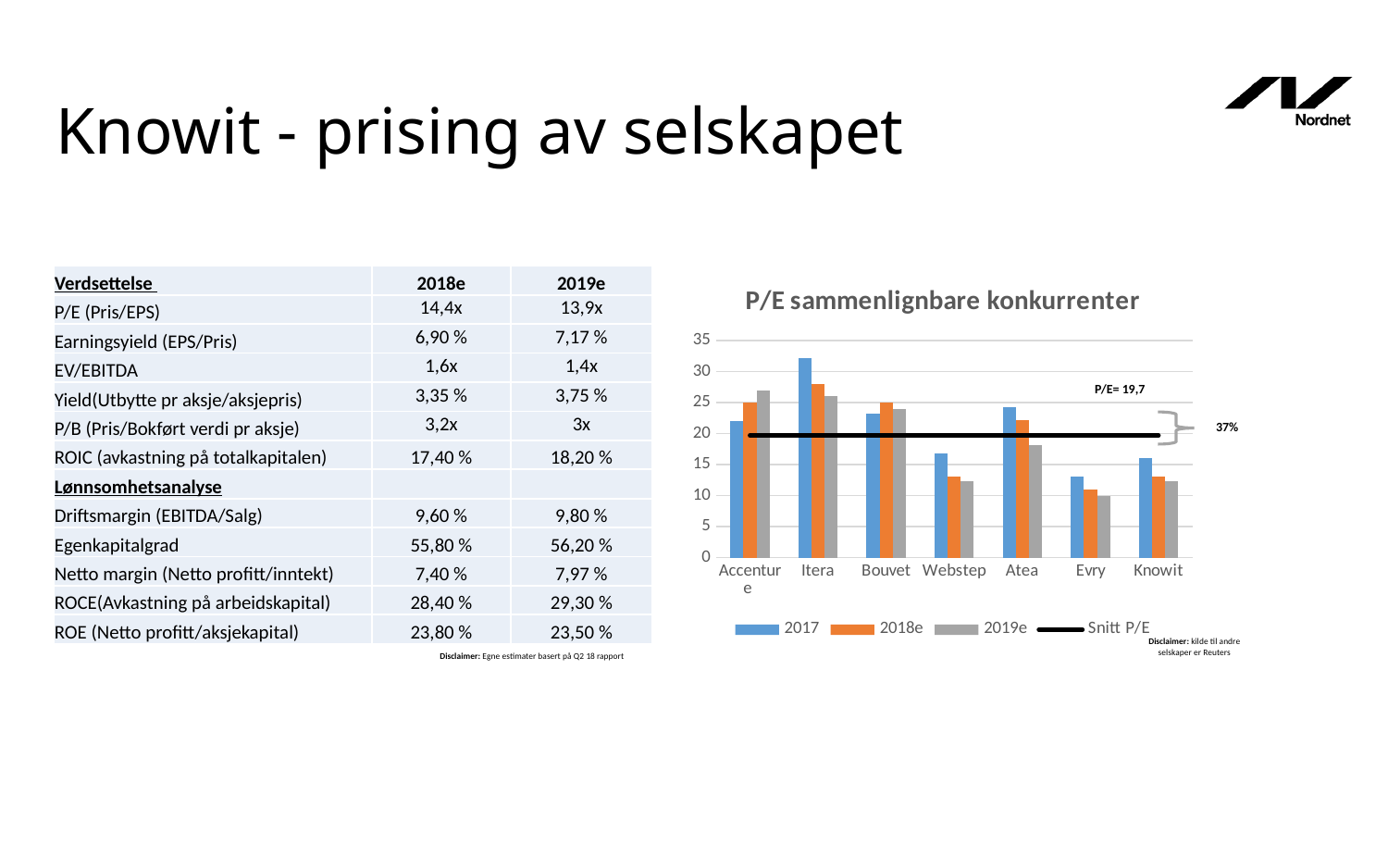
What type of chart is 'P/E sammenlignbare konkurrenter'? combination bar and line chart In the 'P/E sammenlignbare konkurrenter' chart, which company has the highest 2017 bar? Itera How many entries does the legend of the 'P/E sammenlignbare konkurrenter' chart list? 4 What is the title of the chart on the slide? P/E sammenlignbare konkurrenter In the 'P/E sammenlignbare konkurrenter' chart, which is larger: the 2017 value for Atea or the 2017 value for Webstep? Atea How many companies are shown on the x axis of the 'P/E sammenlignbare konkurrenter' chart? 7 In the 'P/E sammenlignbare konkurrenter' chart, do Itera's bars rise or fall from 2017 to 2019e? fall In the 'P/E sammenlignbare konkurrenter' chart, is the 2017 value for Itera greater or less than 30? greater In the 'P/E sammenlignbare konkurrenter' chart, is the 2019e value for Accenture greater or less than 25? greater What P/E value is labelled on the 'Snitt P/E' line in the 'P/E sammenlignbare konkurrenter' chart? 19,7 In the 'P/E sammenlignbare konkurrenter' chart, which company has the lowest 2019e bar? Evry In the 'P/E sammenlignbare konkurrenter' chart, is the 2018e value for Knowit greater or less than 15? less